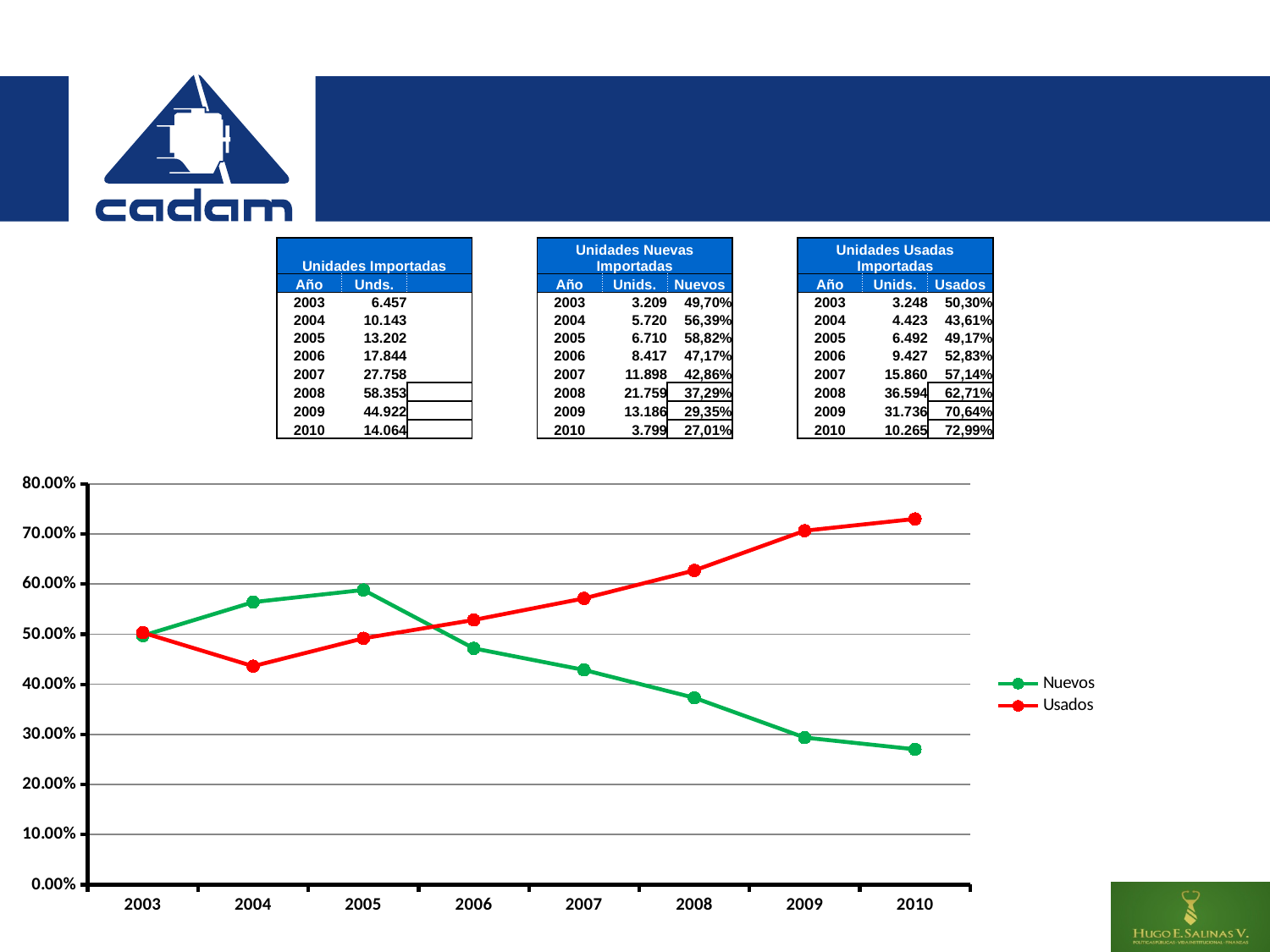
According to the Unidades Nuevas Importadas table, what is the Nuevos percentage for 2008? 37,29% In which year does the Nuevos series reach its lowest value? 2010 Does the Nuevos series rise or fall from 2005 to 2010? fall Is the value for Usados in 2010 greater or less than 70.00%? greater In which year does the Usados series reach its highest value? 2010 In 2007, which series has the larger value, Nuevos or Usados? Usados What kind of chart is shown on the slide? line chart How many series does the chart legend list? 2 Is the value for Nuevos in 2010 greater or less than 30.00%? less Which series is drawn in green in the chart? Nuevos Does the Usados series rise or fall from 2004 to 2010? rise How many years are plotted along the x axis of the chart? 8